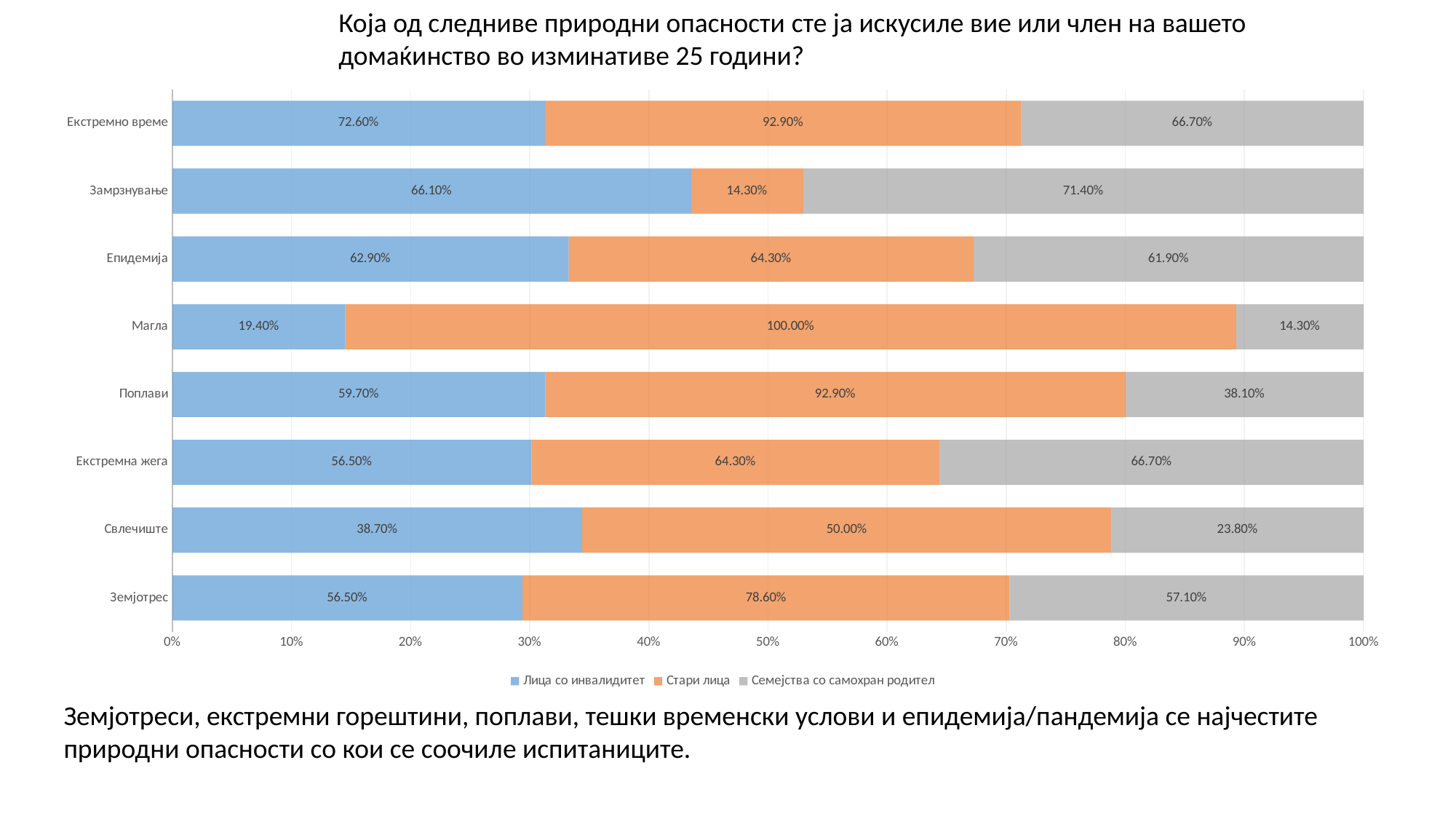
How many series does the legend list? 3 Which is larger for Епидемија: the value for Лица со инвалидитет or the value for Стари лица? Стари лица What kind of chart is shown on the slide? Stacked bar chart Which category has the highest value for Стари лица? Магла How many categories are shown on the chart? 8 What is the value for Стари лица in the Замрзнување category? 14.30% Which category has the highest value for Семејства со самохран родител? Замрзнување What is the difference between the Стари лица values for Поплави and Свлечиште? 42.90% What is the value for Семејства со самохран родител in the Свлечиште category? 23.80% What is the value for Лица со инвалидитет in the Магла category? 19.40% Which series is shown in orange in the legend? Стари лица Which category has the lowest value for Лица со инвалидитет? Магла